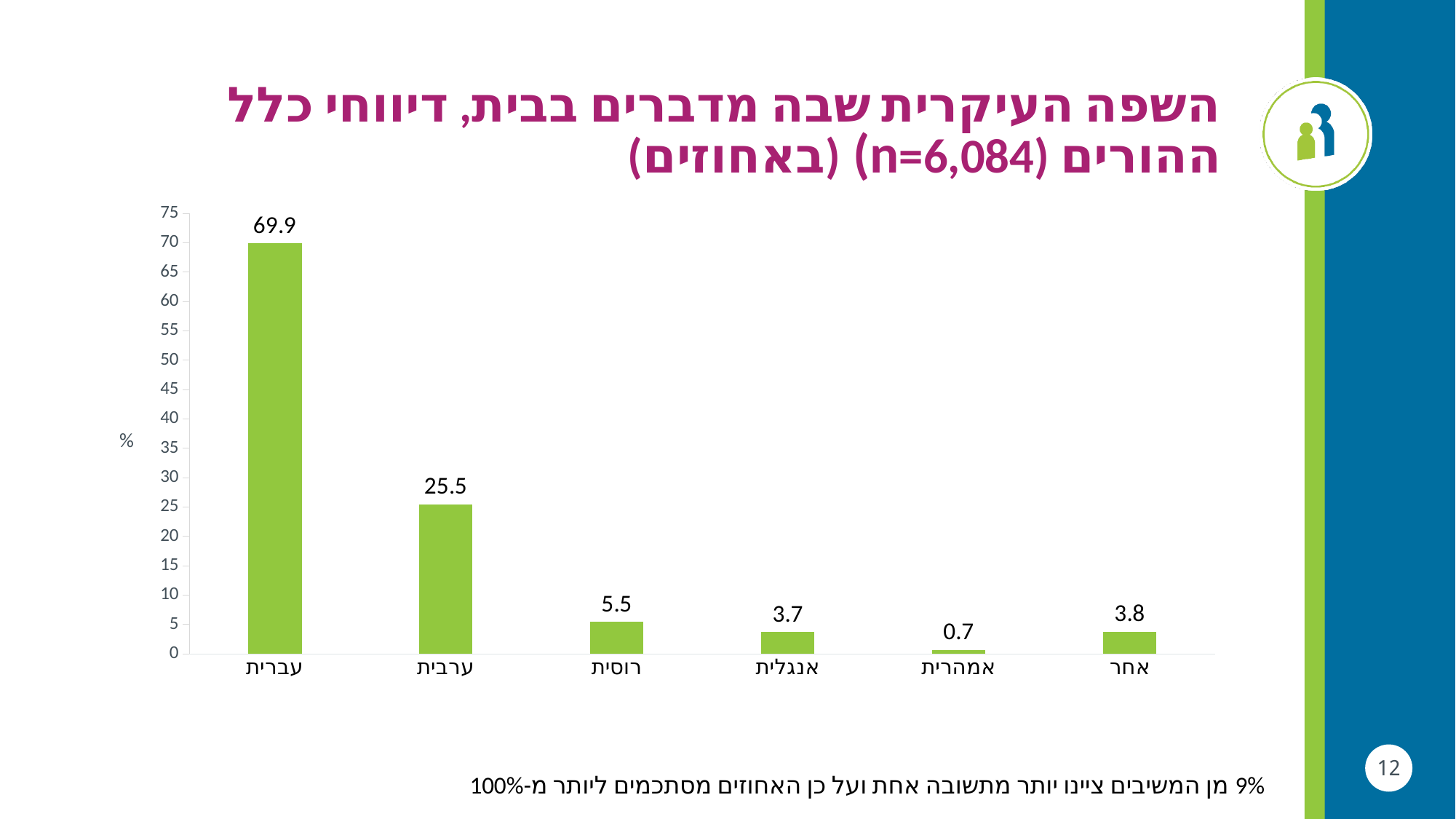
What kind of chart is shown on the slide? bar chart What is the difference between the values for אחר and אנגלית? 0.1 How many categories are shown on the x axis? 6 Which is larger, the value for רוסית or the value for אנגלית? רוסית What is the value for עברית (Hebrew)? 69.9 Which category has the highest value? עברית What is the value for רוסית (Russian)? 5.5 What is the value for ערבית (Arabic)? 25.5 What is the difference between the values for עברית and ערבית? 44.4 What is the value for אמהרית (Amharic)? 0.7 Which category has the lowest value? אמהרית What is the sample size (n) given in the chart title? 6,084